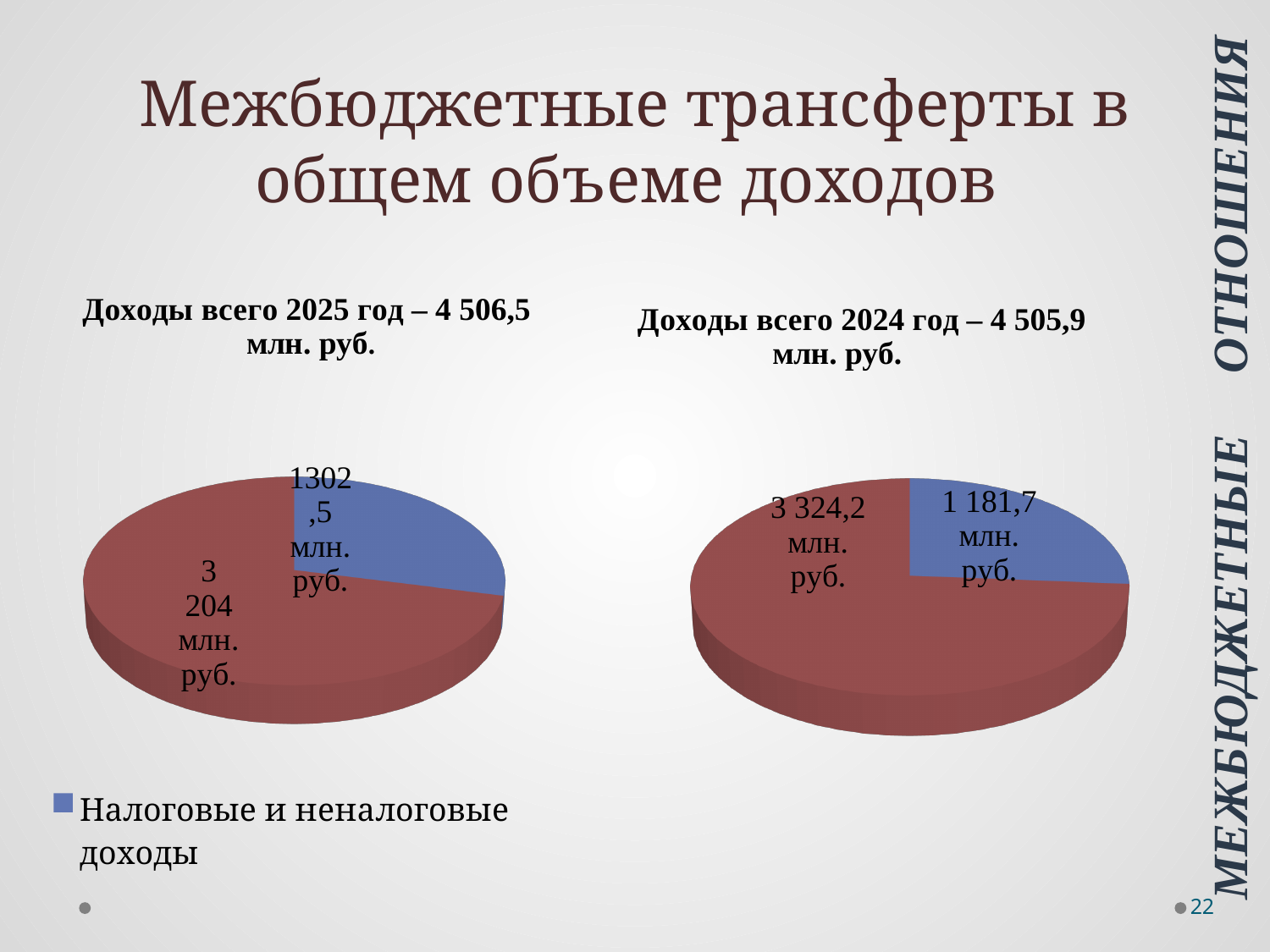
In the 2024 pie chart, what is the difference between the red slice (3 324,2 млн. руб.) and the blue slice (1 181,7 млн. руб.)? 2 142,5 млн. руб. In the 2024 pie chart (Доходы всего 2024 год), what is the value of the blue slice for Налоговые и неналоговые доходы? 1 181,7 млн. руб. In the 2024 pie chart (Доходы всего 2024 год), what is the value of the red slice? 3 324,2 млн. руб. In the 2025 pie chart (Доходы всего 2025 год), what is the value of the blue slice for Налоговые и неналоговые доходы? 1302,5 млн. руб. Which year has the larger value for Налоговые и неналоговые доходы (blue slice), 2025 or 2024? 2025 How many slices does the 2025 pie chart have? 2 In the 2025 pie chart, what is the difference between the red slice (3 204 млн. руб.) and the blue slice (1302,5 млн. руб.)? 1 901,5 млн. руб. In the 2025 pie chart (Доходы всего 2025 год), what is the value of the red slice? 3 204 млн. руб. In the 2025 pie chart, which slice is larger, the blue one or the red one? The red one What total income is stated in the title of the 2024 pie chart? 4 505,9 млн. руб. In the 2024 pie chart, which slice is smaller, the blue one or the red one? The blue one What kind of chart is used on this slide for the 2025 and 2024 income data? Pie chart